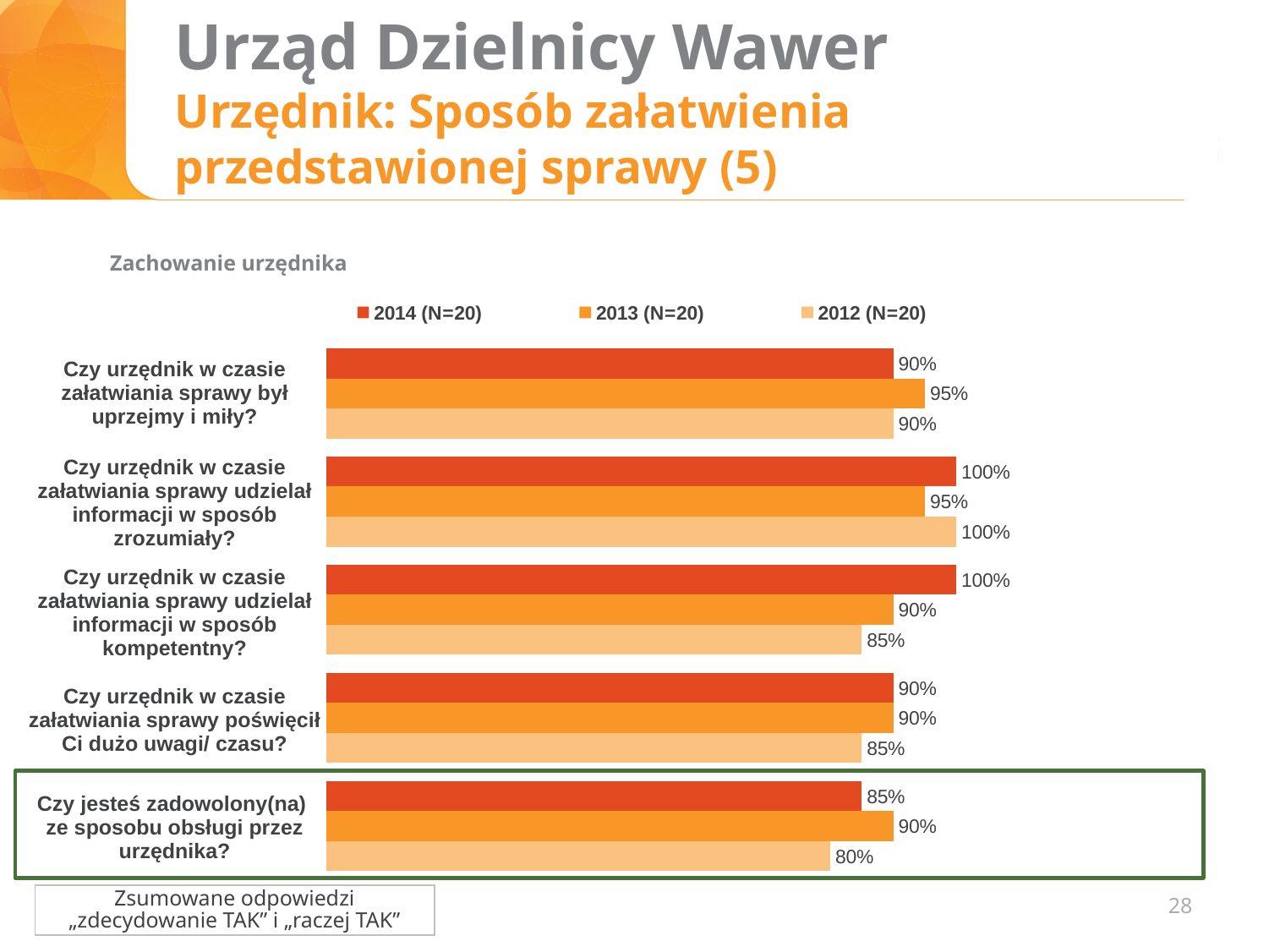
What is the 2012 (N=20) value for "Czy urzędnik w czasie załatwiania sprawy udzielał informacji w sposób kompetentny?"? 85% What kind of chart is shown on the slide? bar chart What is the 2014 (N=20) value for "Czy urzędnik w czasie załatwiania sprawy był uprzejmy i miły?"? 90% Which category has the lowest 2012 (N=20) value? Czy jesteś zadowolony(na) ze sposobu obsługi przez urzędnika? What is the 2013 (N=20) value for "Czy urzędnik w czasie załatwiania sprawy udzielał informacji w sposób zrozumiały?"? 95% What is the 2012 (N=20) value for "Czy jesteś zadowolony(na) ze sposobu obsługi przez urzędnika?"? 80% How many series does the chart legend list? 3 What is the difference between the 2013 (N=20) and 2014 (N=20) values for "Czy urzędnik w czasie załatwiania sprawy był uprzejmy i miły?"? 5% What is the difference between the 2014 (N=20) and 2012 (N=20) values for "Czy urzędnik w czasie załatwiania sprawy udzielał informacji w sposób kompetentny?"? 15% What is the title shown above the chart? Zachowanie urzędnika For "Czy jesteś zadowolony(na) ze sposobu obsługi przez urzędnika?", which is larger: the 2013 (N=20) value or the 2014 (N=20) value? 2013 (N=20) How many question categories are shown in the chart? 5